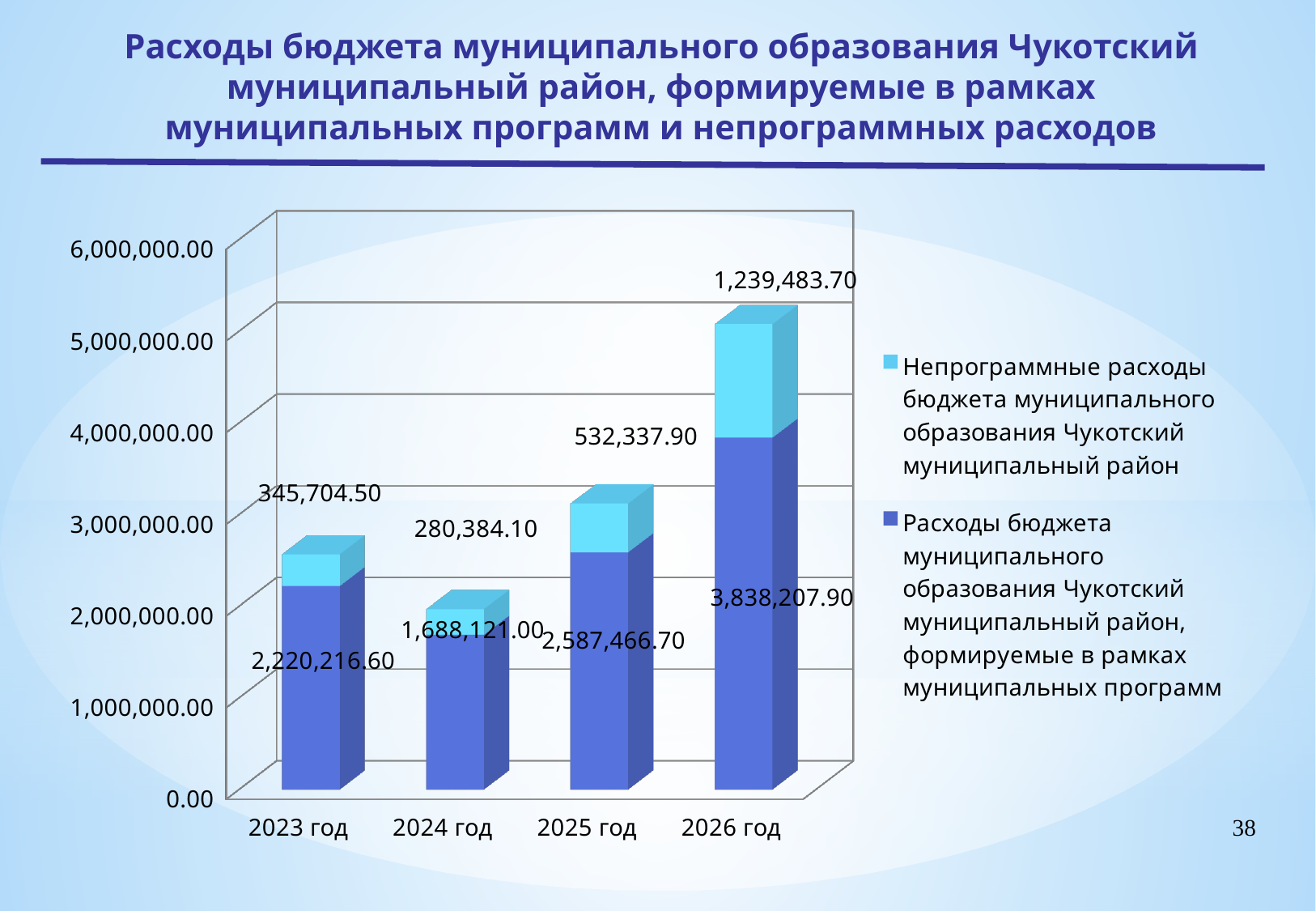
Which year has the lowest non-program expenditures (Непрограммные расходы)? 2024 год Is the total of the stacked bar for 2024 год greater or less than 3,000,000.00? less What is the value of the non-program expenditures (Непрограммные расходы) for 2024 год? 280,384.10 What is the difference between the program expenditures for 2026 год and 2025 год? 1,250,741.20 Which year has the highest program expenditures (Расходы бюджета ... формируемые в рамках муниципальных программ)? 2026 год What is the total of the stacked bar for 2026 год? 5,077,691.60 Which is larger: the non-program expenditures for 2025 год or for 2023 год? 2025 год What type of chart is shown on the slide? Stacked bar chart What is the value of the non-program expenditures (Непрограммные расходы) for 2026 год? 1,239,483.70 How many series does the legend list? 2 What is the value of the program expenditures (Расходы бюджета ... формируемые в рамках муниципальных программ) for 2023 год? 2,220,216.60 How many years (categories) are shown on the x axis? 4